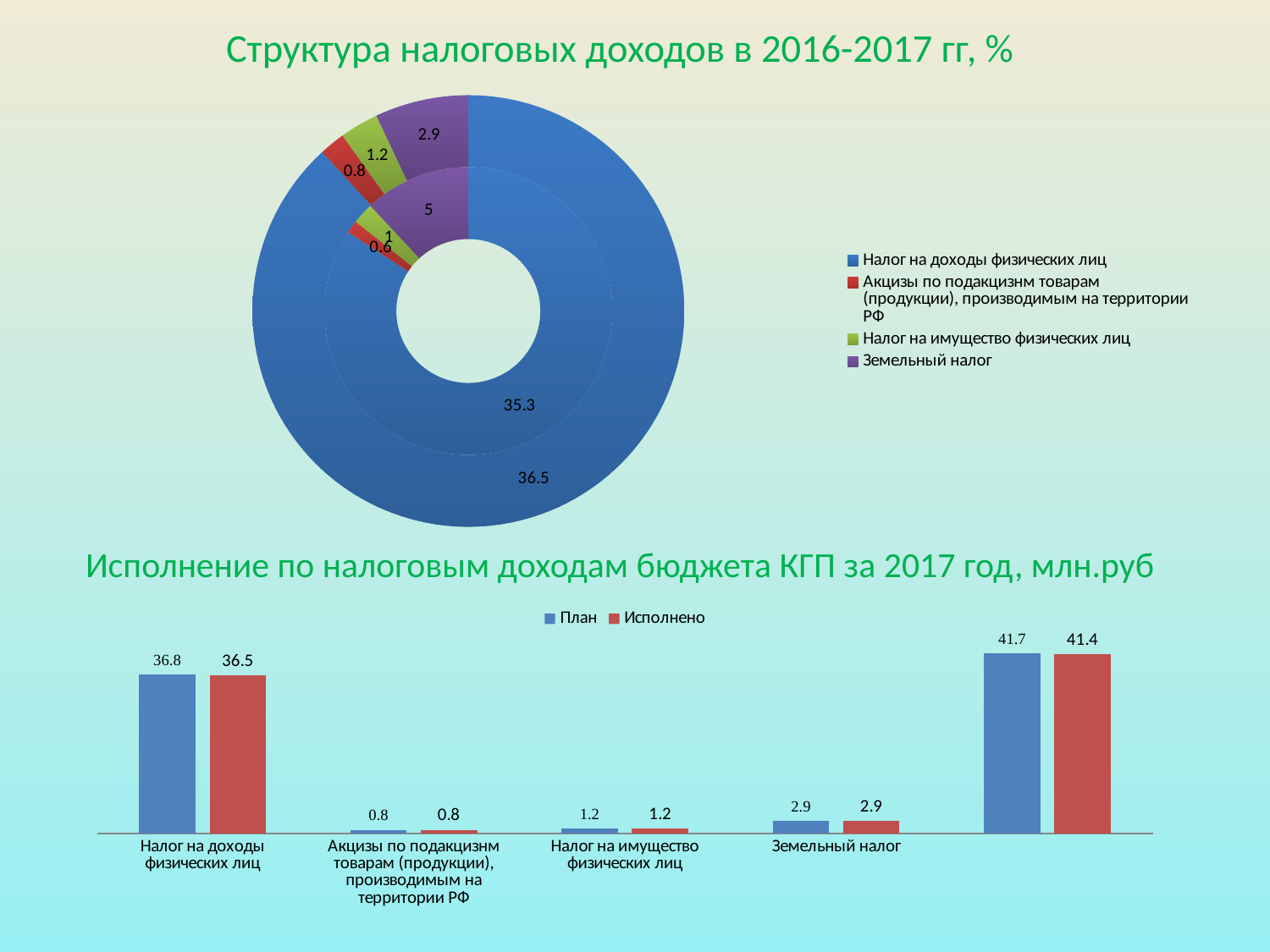
On the bar chart 'Исполнение по налоговым доходам бюджета КГП за 2017 год, млн.руб', what is the План value for Налог на имущество физических лиц? 1.2 On the chart 'Структура налоговых доходов в 2016-2017 гг, %', what is the value of the largest segment in the inner ring? 35.3 On the bar chart 'Исполнение по налоговым доходам бюджета КГП за 2017 год, млн.руб', what is the Исполнено value for Земельный налог? 2.9 On the bar chart 'Исполнение по налоговым доходам бюджета КГП за 2017 год, млн.руб', how many series does the legend list? 2 On the bar chart 'Исполнение по налоговым доходам бюджета КГП за 2017 год, млн.руб', which is larger for Земельный налог: the План value or the Исполнено value? They are equal (2.9) On the bar chart 'Исполнение по налоговым доходам бюджета КГП за 2017 год, млн.руб', what is the Исполнено value for Налог на доходы физических лиц? 36.5 On the chart 'Структура налоговых доходов в 2016-2017 гг, %', how many categories does the legend list? 4 On the bar chart 'Исполнение по налоговым доходам бюджета КГП за 2017 год, млн.руб', what is the difference between the План and Исполнено values for Налог на доходы физических лиц? 0.3 On the chart 'Структура налоговых доходов в 2016-2017 гг, %', what is the value of the largest segment in the outer ring? 36.5 On the bar chart 'Исполнение по налоговым доходам бюджета КГП за 2017 год, млн.руб', what is the План value for Налог на доходы физических лиц? 36.8 On the chart 'Структура налоговых доходов в 2016-2017 гг, %', which category does the blue colour represent? Налог на доходы физических лиц What type of chart is the lower chart 'Исполнение по налоговым доходам бюджета КГП за 2017 год, млн.руб'? Bar chart